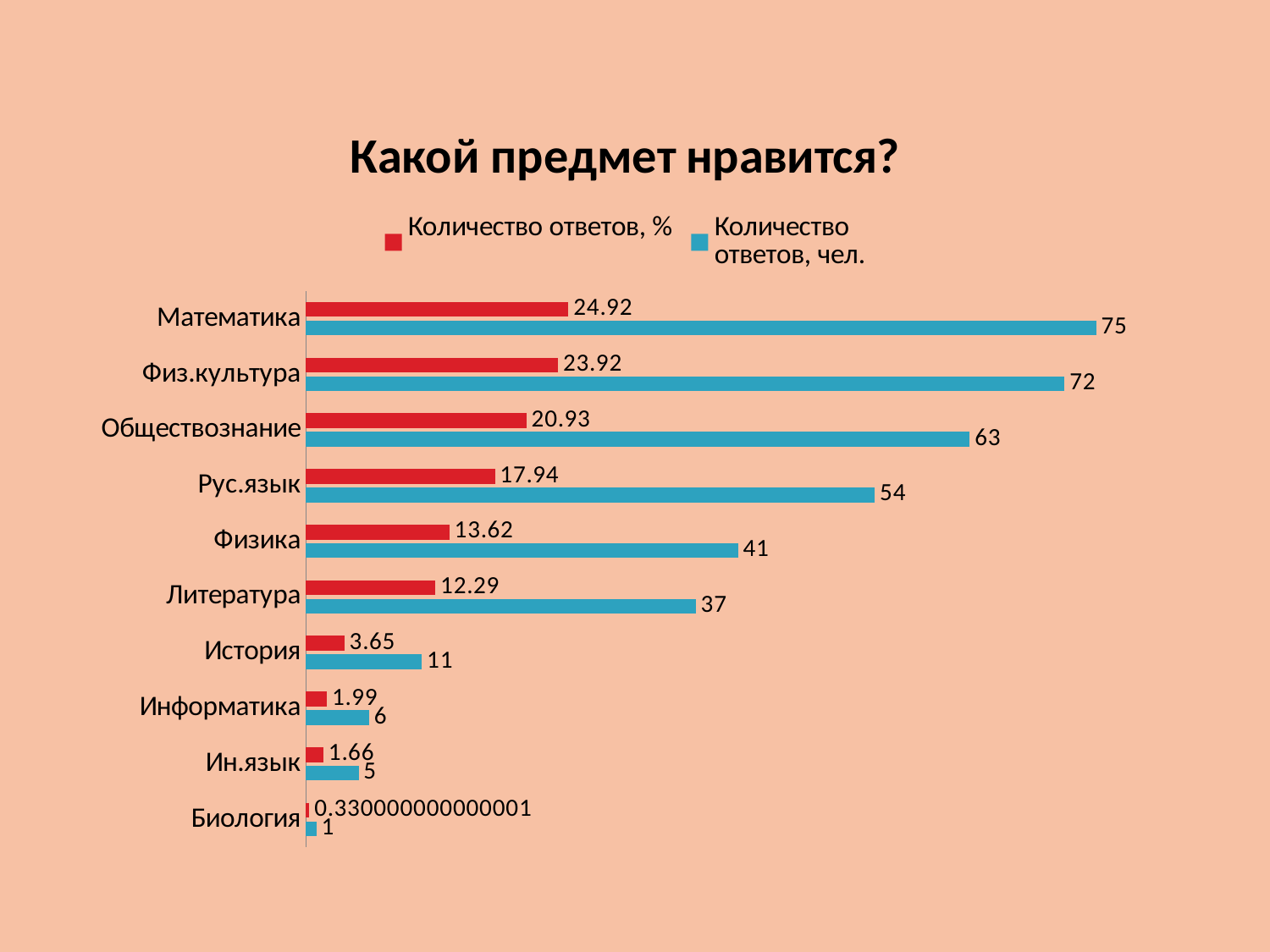
What is the value of 'Количество ответов, чел.' for Математика? 75 How many subjects (categories) are shown on the chart? 10 What is the value of 'Количество ответов, %' for Физ.культура? 23.92 How many series does the legend list? 2 What is the difference in 'Количество ответов, чел.' between Обществознание and Рус.язык? 9 What is the chart's title? Какой предмет нравится? Which subject has the lowest 'Количество ответов, чел.'? Биология What kind of chart is shown on the slide? bar chart Which subject has the highest 'Количество ответов, чел.'? Математика Which has a larger 'Количество ответов, чел.': Физика or История? Физика What is the value of 'Количество ответов, %' for История? 3.65 What is the value of 'Количество ответов, чел.' for Литература? 37